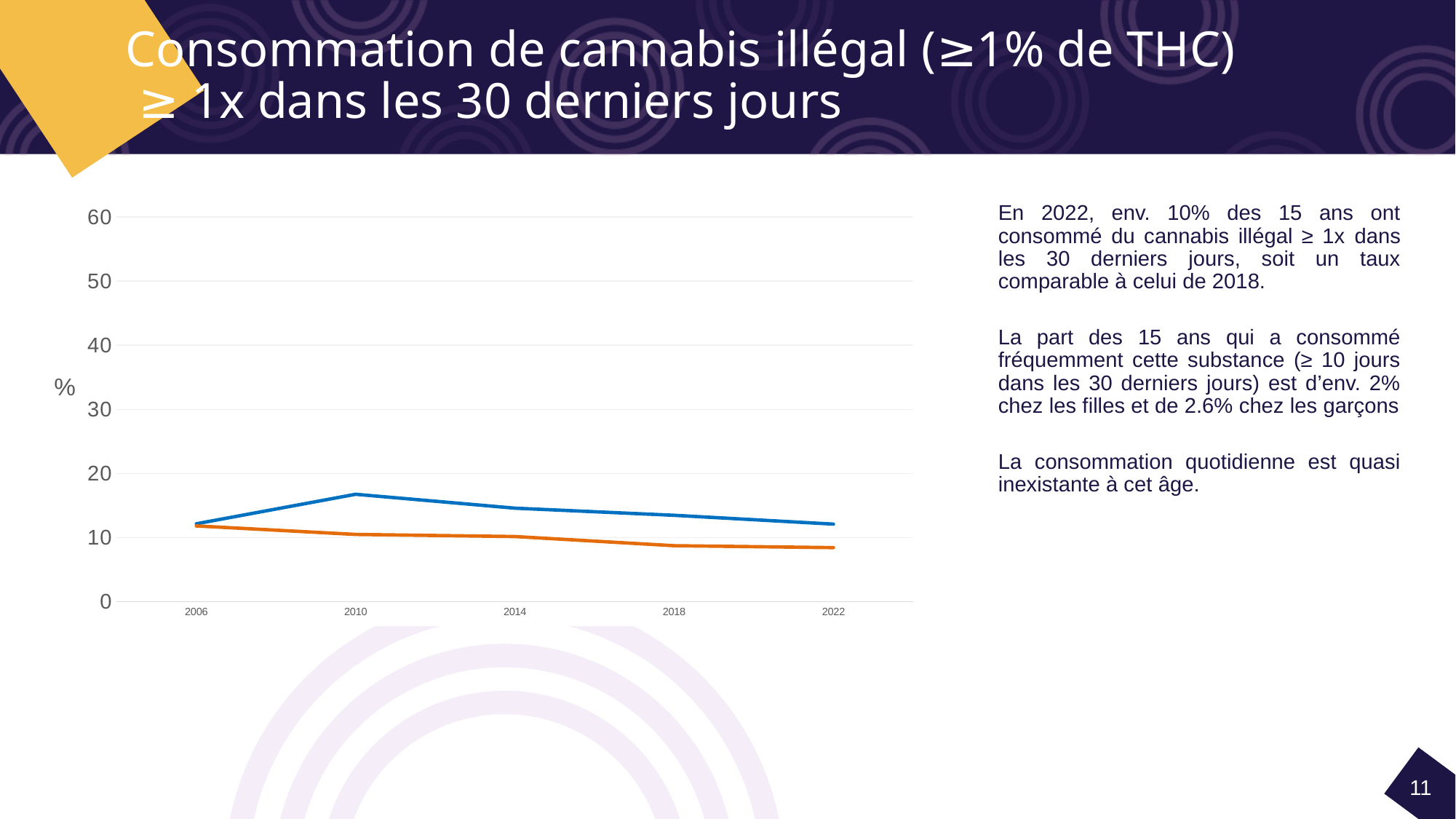
Is the value of the blue line in 2010 greater or less than 20? less What kind of chart is shown on the slide? line chart Does the blue line rise or fall from 2010 to 2022? fall Does the orange line rise or fall from 2006 to 2022? fall In 2010, which line has the higher value, the blue line or the orange line? the blue line What label is shown on the y axis of the chart? % Is the value of the blue line in 2022 greater or less than 10? greater Is the value of the orange line in 2022 greater or less than 10? less How many lines are plotted on the chart? 2 In which year does the blue line reach its highest value? 2010 How many years are shown on the x axis of the chart? 5